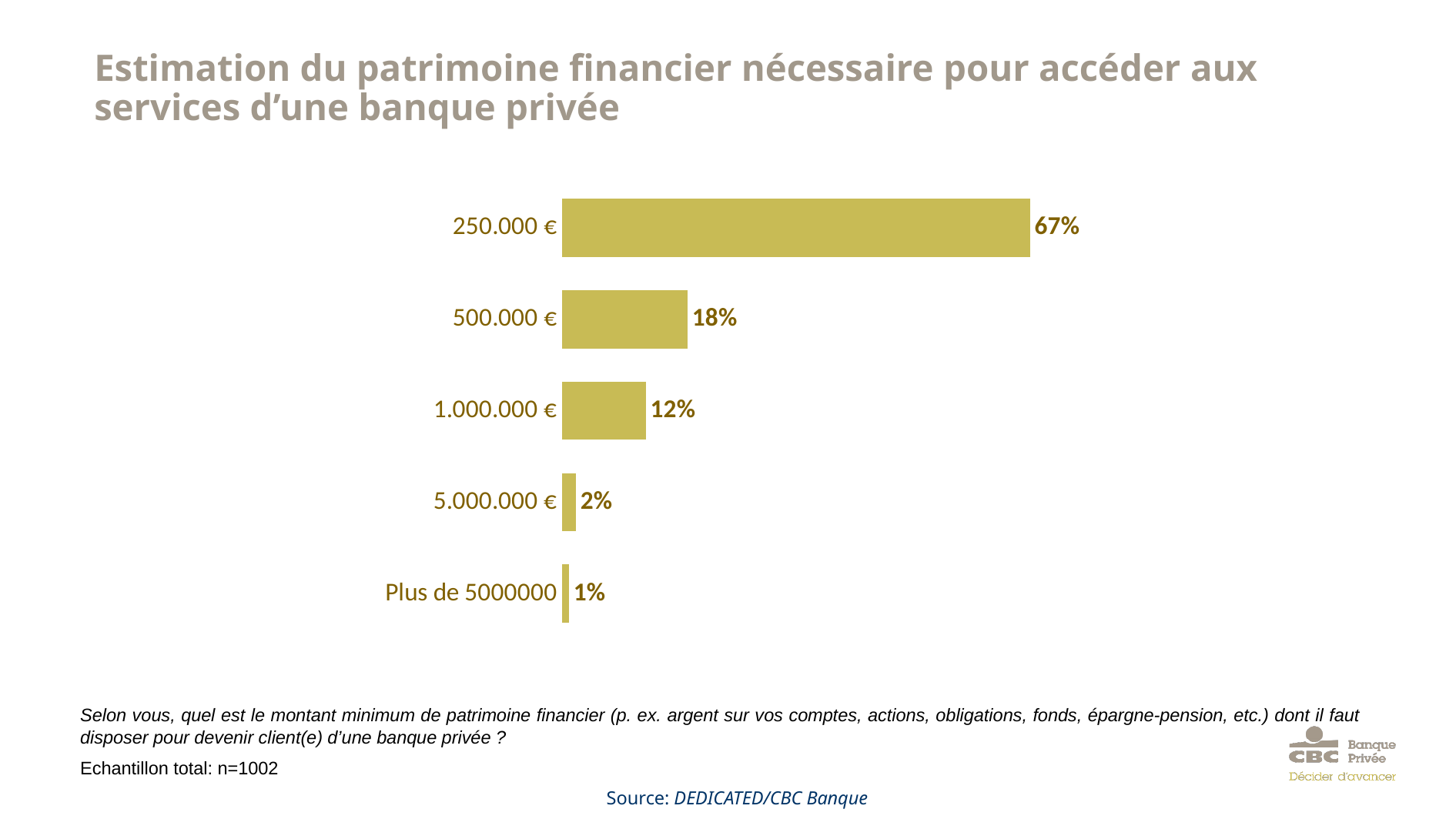
What percentage is shown for 1.000.000 €? 12% What percentage of respondents estimated 250.000 € as the minimum financial wealth needed? 67% How many categories are shown in the chart? 5 What is the difference between the values for 250.000 € and 500.000 €? 49% What is the total sample size stated on the slide? n=1002 What is the value for the 'Plus de 5000000' category? 1% What is the value shown for the 500.000 € category? 18% What type of chart is shown on the slide? Bar chart Which category has the lowest value? Plus de 5000000 Which is larger, the value for 500.000 € or the value for 1.000.000 €? 500.000 € Which category has the highest value? 250.000 € What is the difference between the values for 1.000.000 € and 5.000.000 €? 10%